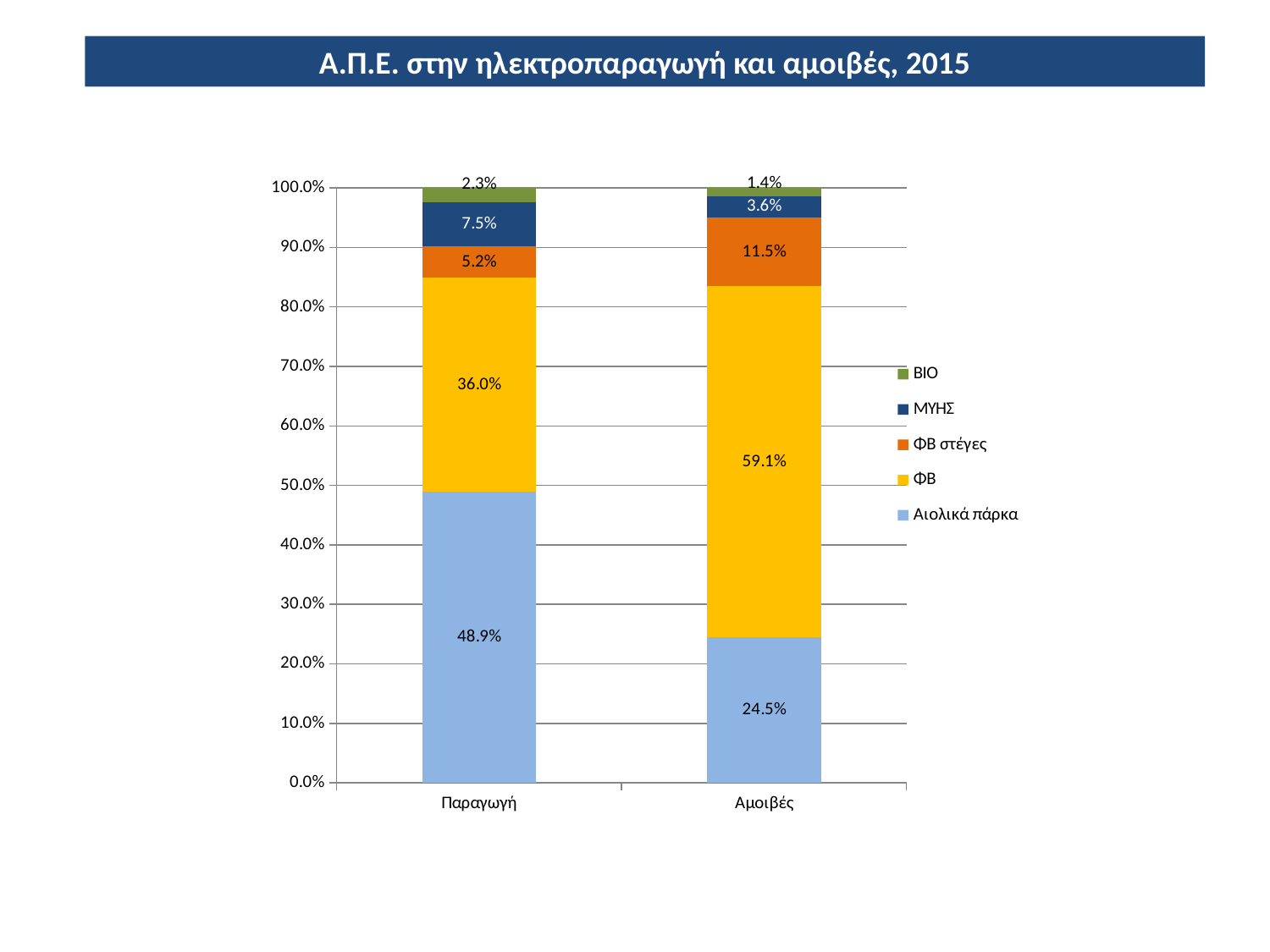
Is the Αιολικά πάρκα value larger for Παραγωγή or for Αμοιβές? Παραγωγή How many series does the legend list? 5 Which series has the smallest share in the Αμοιβές bar? BIO What is the value of BIO for Αμοιβές? 1.4% What is the value of ΜΥΗΣ for Παραγωγή? 7.5% What kind of chart is shown on the slide? Stacked bar chart Which series has the largest share in the Παραγωγή bar? Αιολικά πάρκα What is the value of ΦΒ for Αμοιβές? 59.1% What is the value of ΦΒ στέγες for Αμοιβές? 11.5% How many categories are shown on the x axis? 2 What is the value of Αιολικά πάρκα for Παραγωγή? 48.9% How much larger is the ΦΒ value for Αμοιβές than for Παραγωγή? 23.1 percentage points